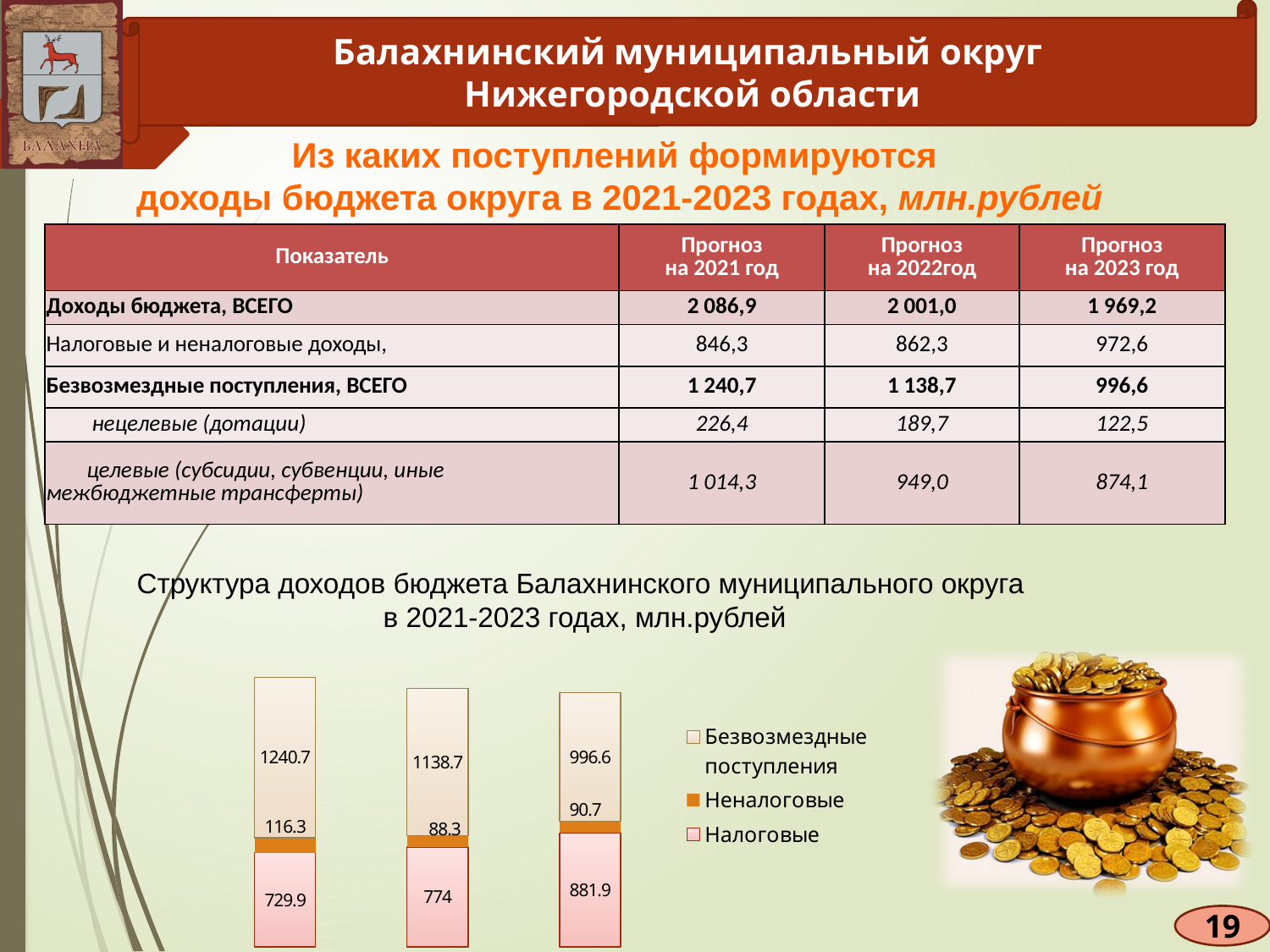
How many bars does the chart show? 3 Which is larger: the Неналоговые value in the leftmost bar or in the middle bar? the leftmost bar Which bar has the lowest Безвозмездные поступления value? the rightmost bar Which bar has the highest Налоговые value? the rightmost bar What is the difference between the Налоговые values of the rightmost and leftmost bars? 152 What is the value of the Налоговые segment in the middle bar? 774 What kind of chart is shown at the bottom of the slide? stacked bar chart What is the value of the Безвозмездные поступления segment in the leftmost bar? 1240.7 How many series does the chart legend list? 3 What is the total of the leftmost stacked bar? 2086.9 What is the total of the rightmost stacked bar? 1969.2 What is the value of the Неналоговые segment in the rightmost bar? 90.7